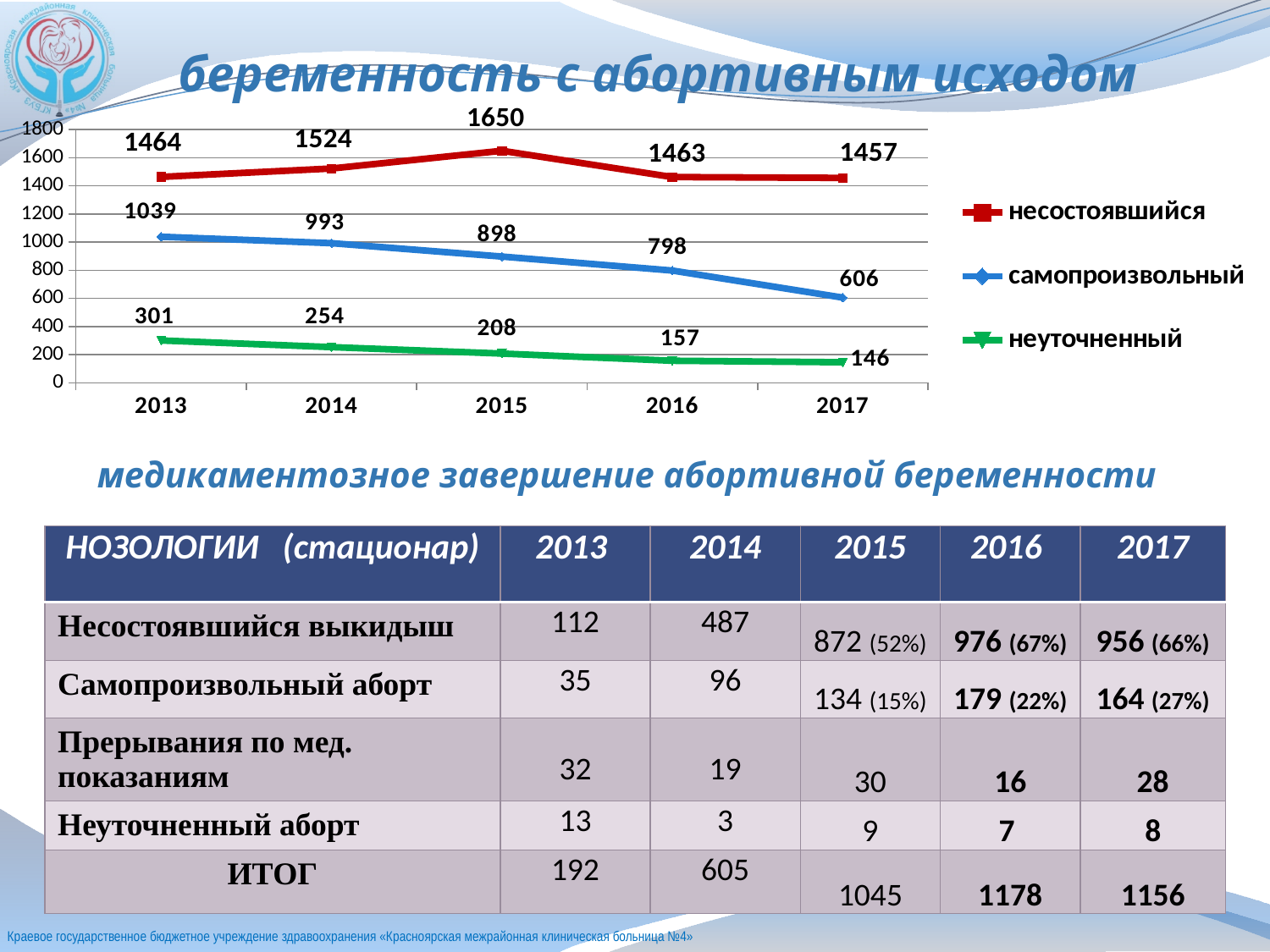
Does the самопроизвольный series rise or fall from 2013 to 2017? fall What type of chart is shown on the slide? line chart What is the value for самопроизвольный in 2017? 606 What is the difference between the самопроизвольный values in 2013 and 2017? 433 How many years are shown on the x axis of the chart? 5 What is the value for несостоявшийся in 2015? 1650 How many series does the chart legend list? 3 Which colour is used for the несостоявшийся series? red In which year is the неуточненный series lowest? 2017 In which year is the несостоявшийся series highest? 2015 Which is larger: несостоявшийся in 2014 or несостоявшийся in 2016? 2014 What is the value for неуточненный in 2013? 301